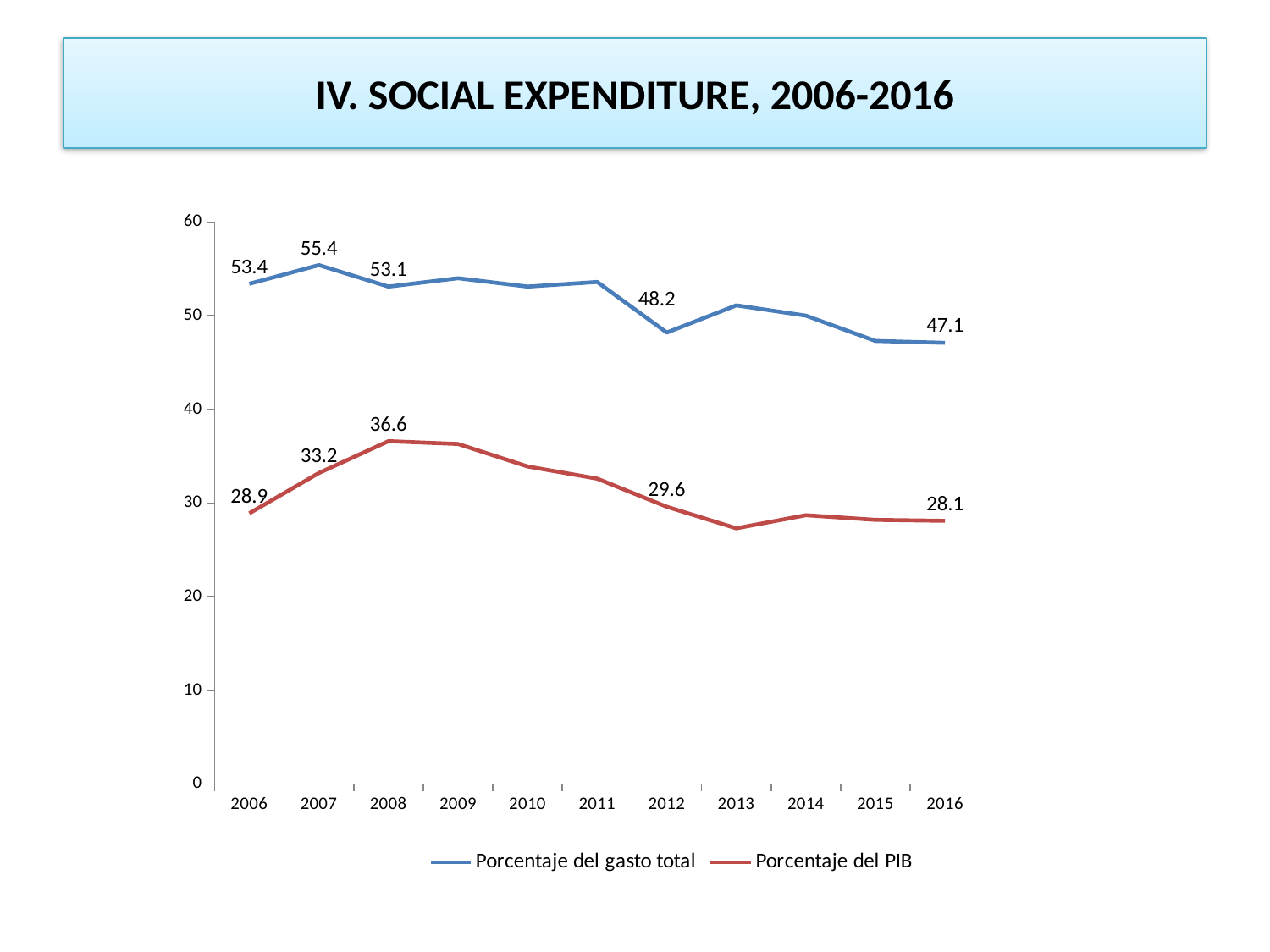
How many years are shown on the x axis? 11 What is the difference between Porcentaje del gasto total in 2006 and in 2016? 6.3 In which year does Porcentaje del PIB reach its highest value? 2008 What type of chart is shown on the slide? Line chart How many series does the legend list? 2 Which is larger in 2012: Porcentaje del gasto total or Porcentaje del PIB? Porcentaje del gasto total What is the value of Porcentaje del gasto total in 2007? 55.4 What is the value of Porcentaje del PIB in 2006? 28.9 What is the value of Porcentaje del gasto total in 2016? 47.1 What is the value of Porcentaje del PIB in 2008? 36.6 In which year does Porcentaje del gasto total reach its highest labelled value? 2007 Is the value for Porcentaje del PIB in 2013 greater or less than 30? less